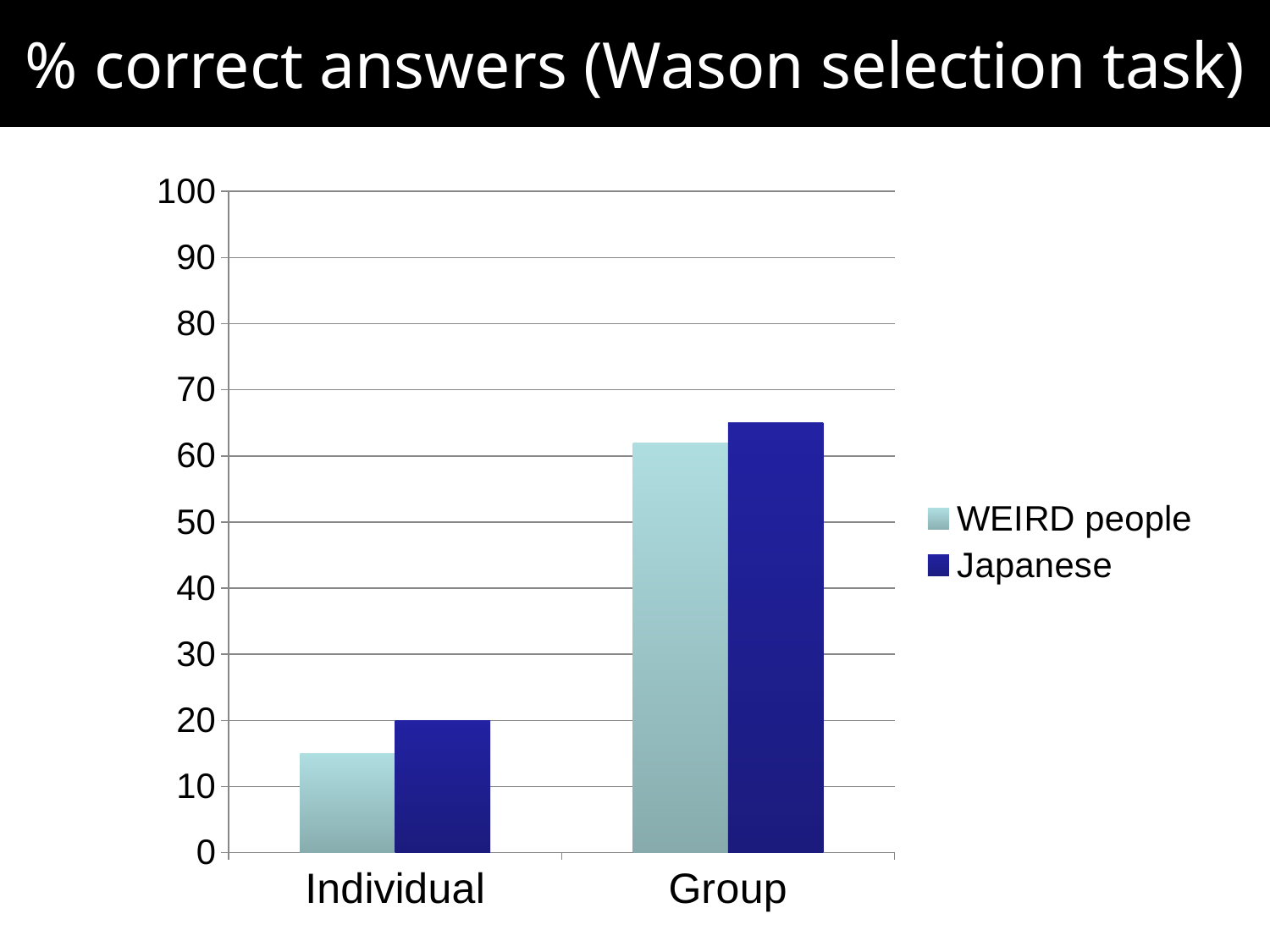
Is the value for Japanese in the Individual condition greater or less than 30? less Is the value for WEIRD people in the Individual condition greater or less than 20? less Which category has the highest value for the Japanese series? Group Which category has the lowest value for the WEIRD people series? Individual Do the values rise or fall from Individual to Group? rise What is the title of the chart? % correct answers (Wason selection task) How many series does the legend list? 2 What kind of chart is shown on the slide? bar chart Is the value for WEIRD people in the Group condition greater or less than 60? greater Which is larger for WEIRD people: the Individual value or the Group value? Group How many categories are shown on the x axis? 2